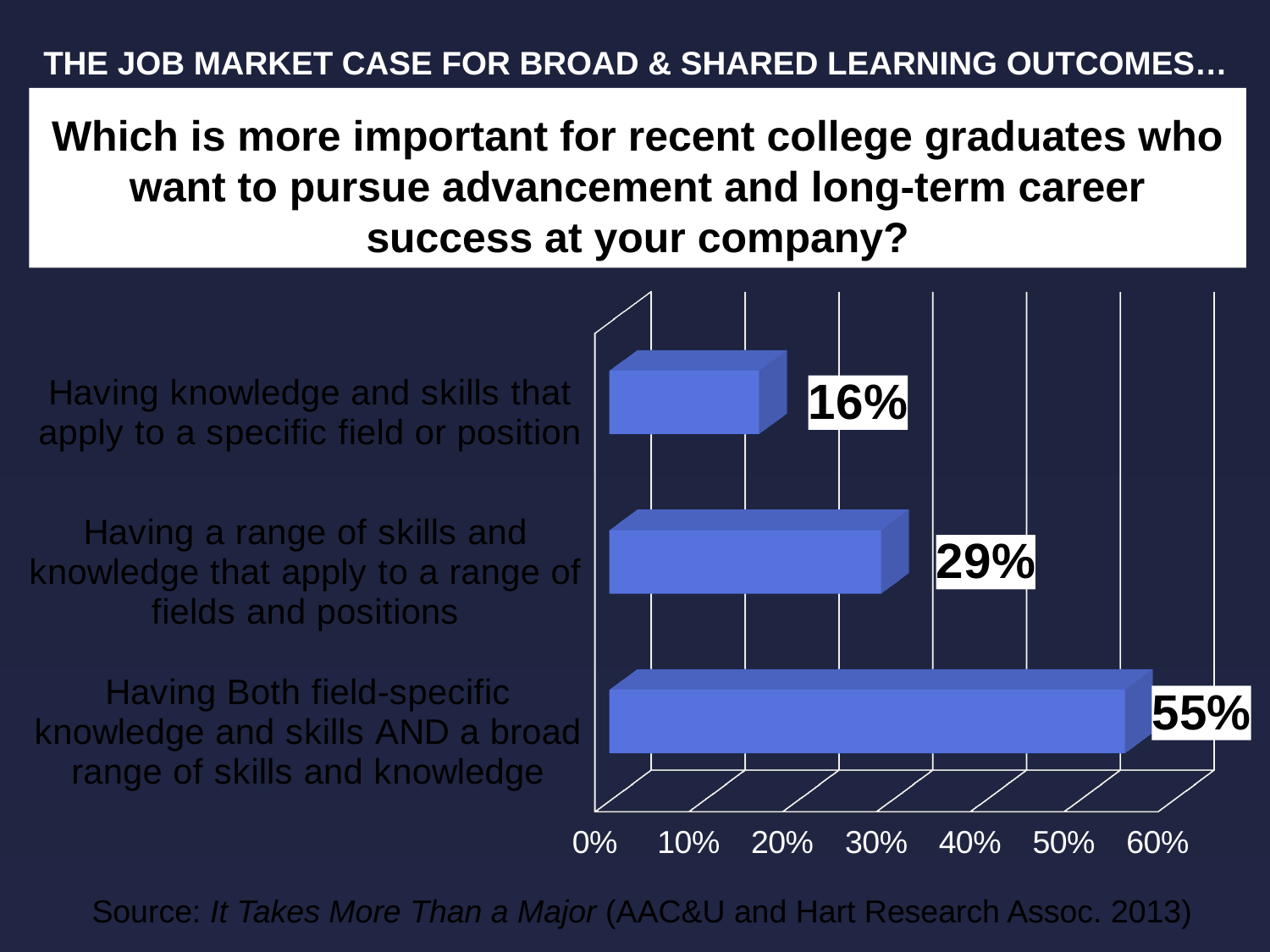
What is the difference between the value for 'Having Both field-specific knowledge and skills AND a broad range of skills and knowledge' and the value for 'Having a range of skills and knowledge that apply to a range of fields and positions'? 26% What is the difference between the value for 'Having a range of skills and knowledge that apply to a range of fields and positions' and the value for 'Having knowledge and skills that apply to a specific field or position'? 13% Which category has the lowest value? Having knowledge and skills that apply to a specific field or position How many categories are shown in the chart? 3 What is the value for 'Having a range of skills and knowledge that apply to a range of fields and positions'? 29% Which category has the highest value? Having Both field-specific knowledge and skills AND a broad range of skills and knowledge What is the highest value shown on the chart's percentage axis? 60% Which is larger: the value for 'Having a range of skills and knowledge that apply to a range of fields and positions' or the value for 'Having knowledge and skills that apply to a specific field or position'? Having a range of skills and knowledge that apply to a range of fields and positions What kind of chart is shown on the slide? Bar chart What is the value for 'Having knowledge and skills that apply to a specific field or position'? 16% Is the value for 'Having Both field-specific knowledge and skills AND a broad range of skills and knowledge' greater or less than 50%? greater What percentage of employers chose 'Having Both field-specific knowledge and skills AND a broad range of skills and knowledge'? 55%